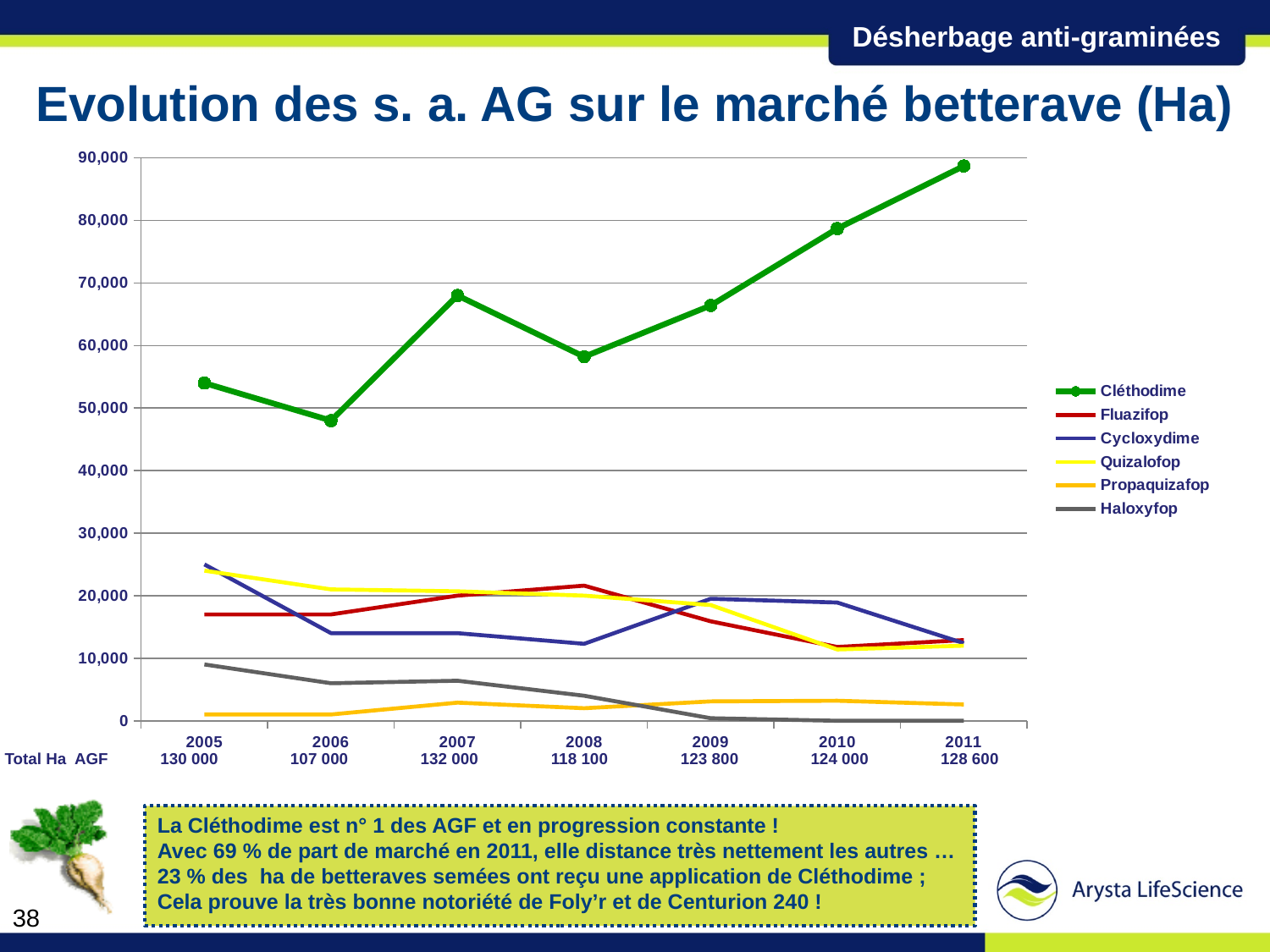
Which series has the highest value in 2011? Cléthodime Is the value for Cléthodime in 2006 greater or less than 50,000? less What kind of chart is shown on the slide? line chart Does the Cléthodime line rise or fall from 2009 to 2011? rise How many series does the legend list? 6 What is the Total Ha AGF shown for 2006? 107 000 Which series has the lowest value in 2011? Haloxyfop What is the difference between the Total Ha AGF for 2007 and for 2006? 25 000 How many years are plotted along the x axis? 7 Which year has the highest Total Ha AGF shown below the chart? 2007 Is the value for Cléthodime in 2011 greater or less than 80,000? greater